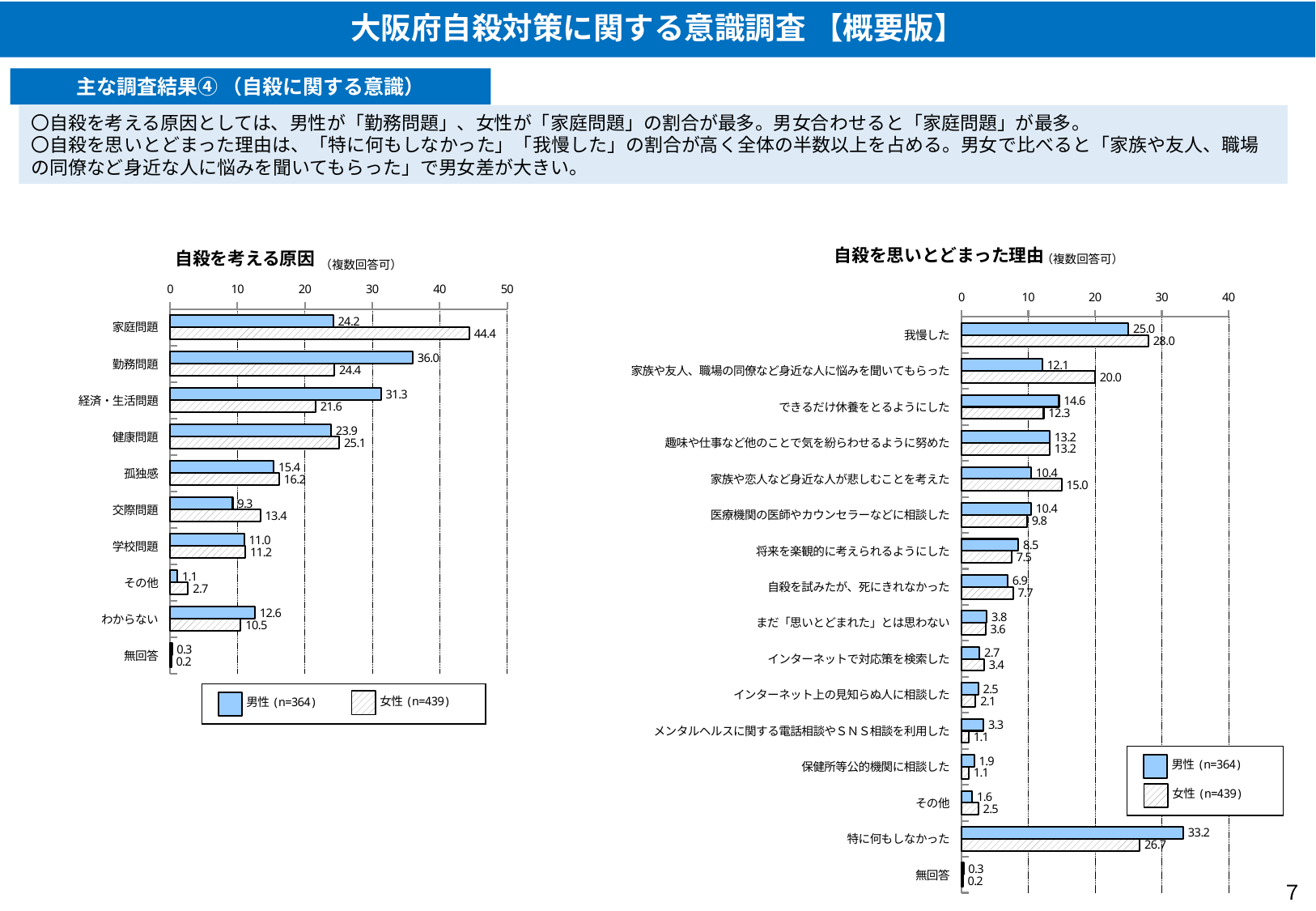
In the chart titled 自殺を考える原因, what is the difference between the 女性 and 男性 values for 家庭問題? 20.2 In the chart titled 自殺を思いとどまった理由, what is the difference between the 女性 and 男性 values for 家族や友人、職場の同僚など身近な人に悩みを聞いてもらった? 7.9 In the chart titled 自殺を考える原因, how many categories are shown? 10 In the chart titled 自殺を考える原因, what is the value for 男性 for 勤務問題? 36.0 In the chart titled 自殺を考える原因, which is larger for 健康問題, the 男性 value or the 女性 value? 女性 In the chart titled 自殺を思いとどまった理由, which category has the highest value for 女性? 我慢した What kind of chart is the chart titled 自殺を思いとどまった理由? Bar chart In the chart titled 自殺を考える原因, which category has the highest value for 男性? 勤務問題 In the chart titled 自殺を考える原因, what is the value for 女性 for 家庭問題? 44.4 In the chart titled 自殺を思いとどまった理由, what is the value for 女性 for 家族や友人、職場の同僚など身近な人に悩みを聞いてもらった? 20.0 In the chart titled 自殺を思いとどまった理由, how many series does the legend list? 2 In the chart titled 自殺を思いとどまった理由, what is the value for 男性 for 特に何もしなかった? 33.2